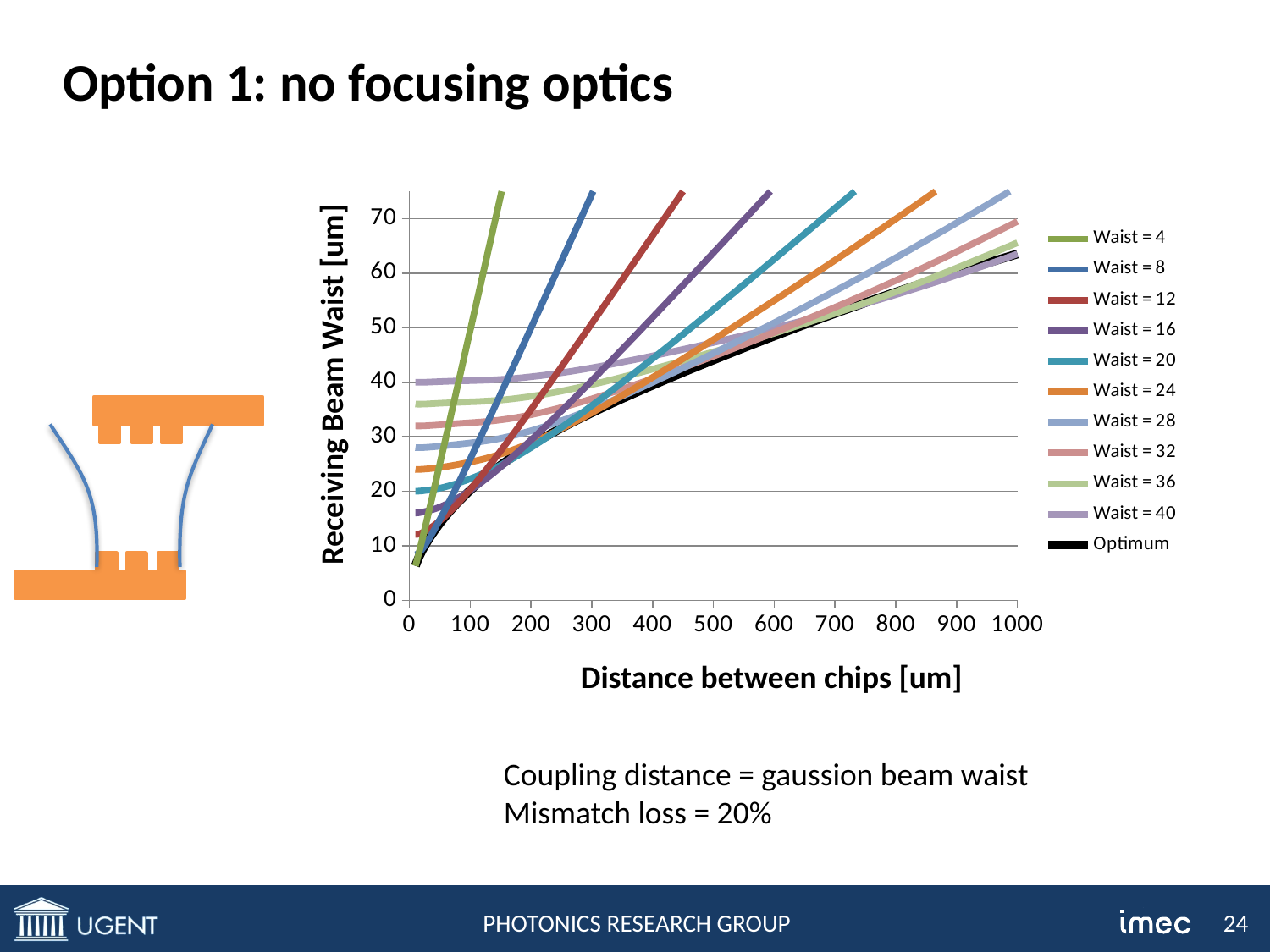
Is the value of the Waist = 40 series at a distance of 100 um greater or less than 30? greater Is the value of the Waist = 12 series at a distance of 200 um greater or less than 30? greater What is the label of the x axis of the chart? Distance between chips [um] What is the label of the y axis of the chart? Receiving Beam Waist [um] Does the Waist = 4 series rise or fall as the distance between chips increases? rise Does the Optimum series rise or fall as the distance between chips increases? rise How many series does the chart legend list? 11 Is the value of the Waist = 8 series at a distance of 300 um greater or less than 60? greater At a distance of 200 um, which series has the larger value: Waist = 8 or Waist = 40? Waist = 8 What kind of chart is shown on the slide? line chart Which series has the highest receiving beam waist at the smallest distance between chips? Waist = 40